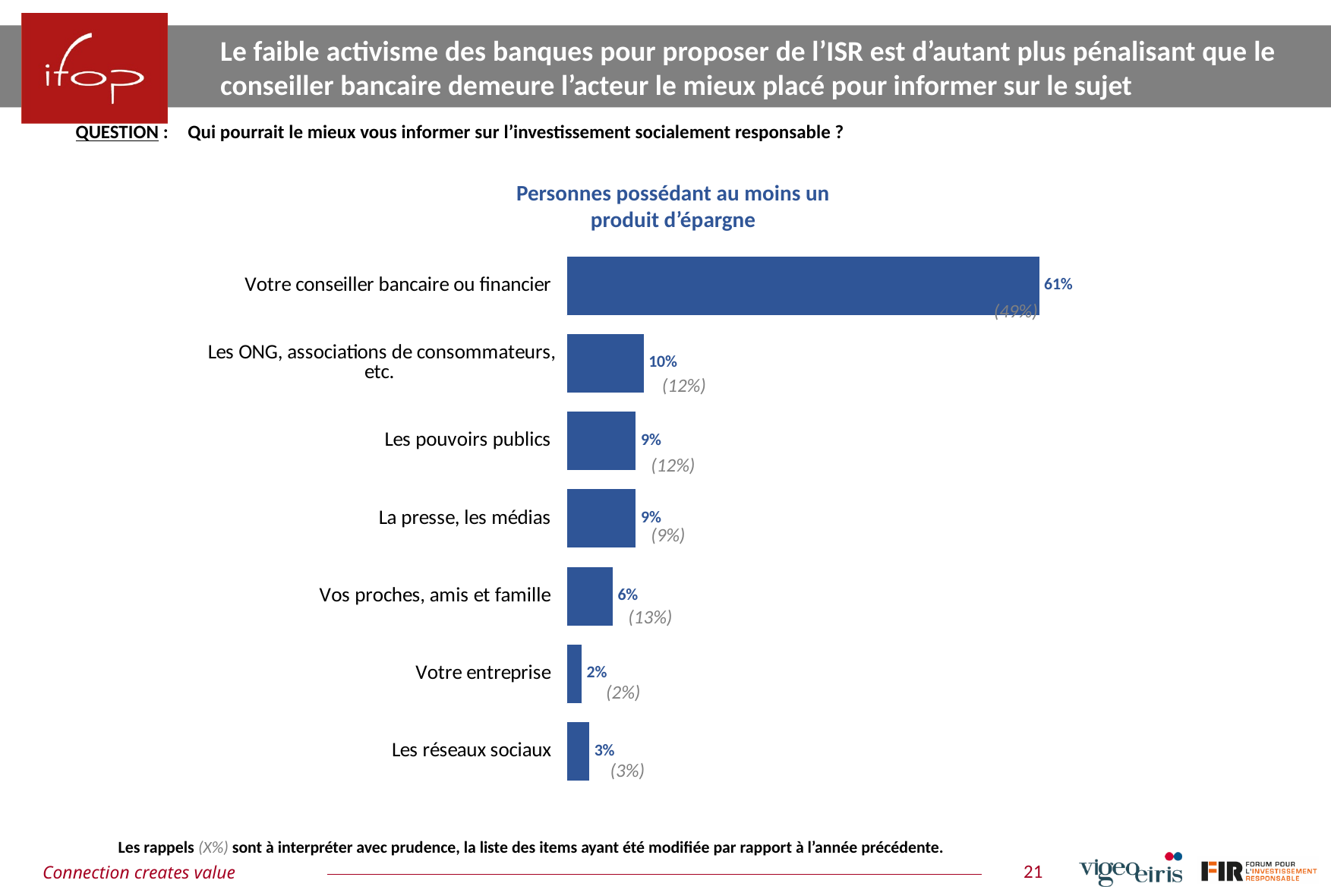
What is the difference between the values for "Votre conseiller bancaire ou financier" and "Les ONG, associations de consommateurs, etc."? 51% What is the title of the chart? Personnes possédant au moins un produit d'épargne What percentage of people owning at least one savings product chose "Votre conseiller bancaire ou financier"? 61% Which category has the highest value in the chart? Votre conseiller bancaire ou financier What is the value shown for "Vos proches, amis et famille"? 6% What is the value shown for "Les ONG, associations de consommateurs, etc."? 10% Which category has the lowest value in the chart? Votre entreprise What is the value shown for "Les réseaux sociaux"? 3% How many categories are shown in the chart? 7 Which is larger, the value for "Les réseaux sociaux" or the value for "Votre entreprise"? Les réseaux sociaux What is the previous-year value shown in parentheses for "Vos proches, amis et famille"? (13%) What kind of chart is shown on the slide? Bar chart